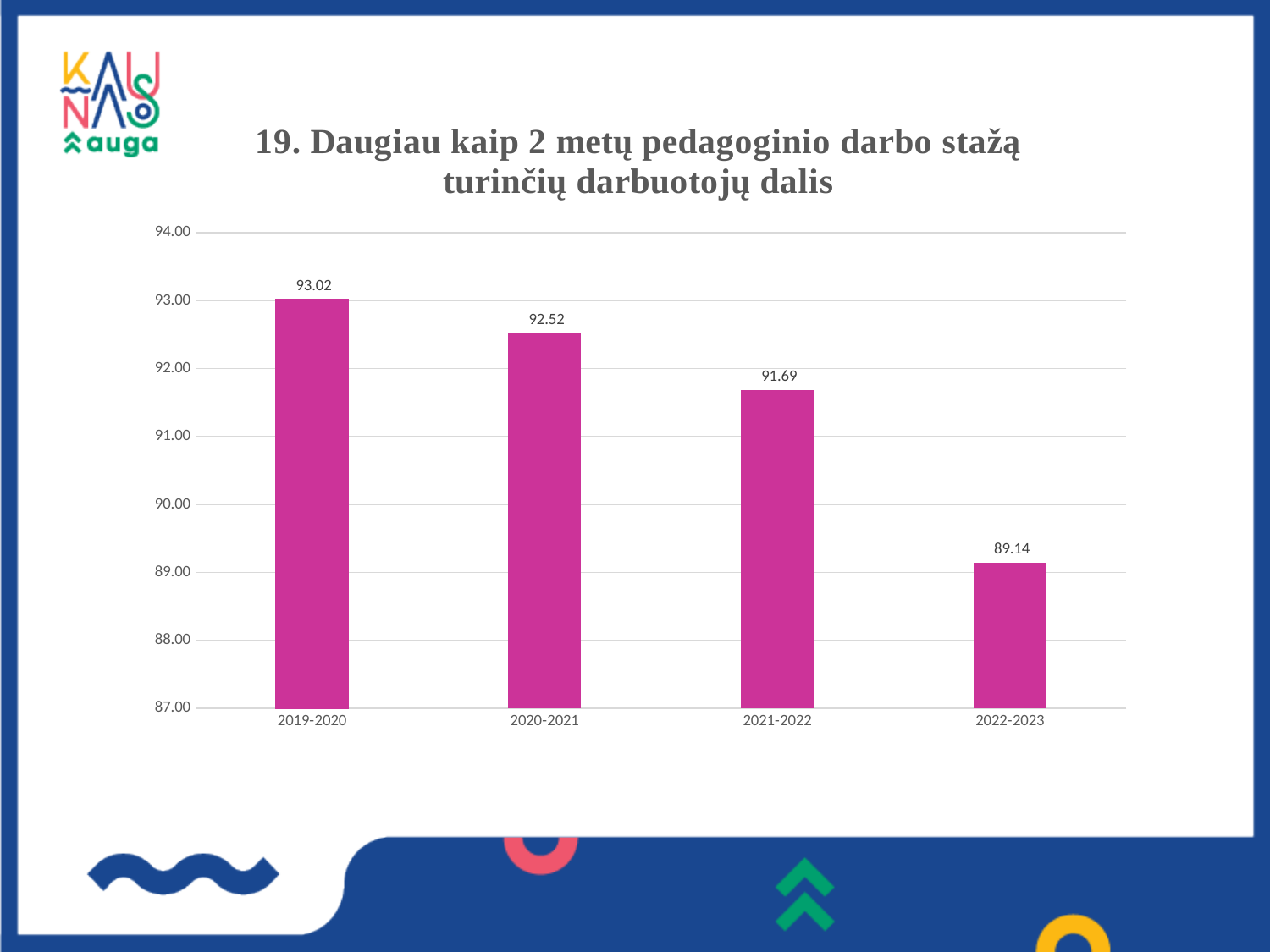
What is the value for 2020-2021? 92.52 What kind of chart is this? Bar chart What is the value for 2021-2022? 91.69 Which is larger, the value for 2020-2021 or the value for 2021-2022? 2020-2021 Do the values rise or fall from 2019-2020 to 2022-2023? Fall What is the value for 2022-2023? 89.14 Which year has the highest value? 2019-2020 Which year has the lowest value? 2022-2023 How many years are shown on the x axis? 4 What is the value for 2019-2020? 93.02 What is the difference between the values for 2020-2021 and 2021-2022? 0.83 What is the difference between the values for 2019-2020 and 2022-2023? 3.88